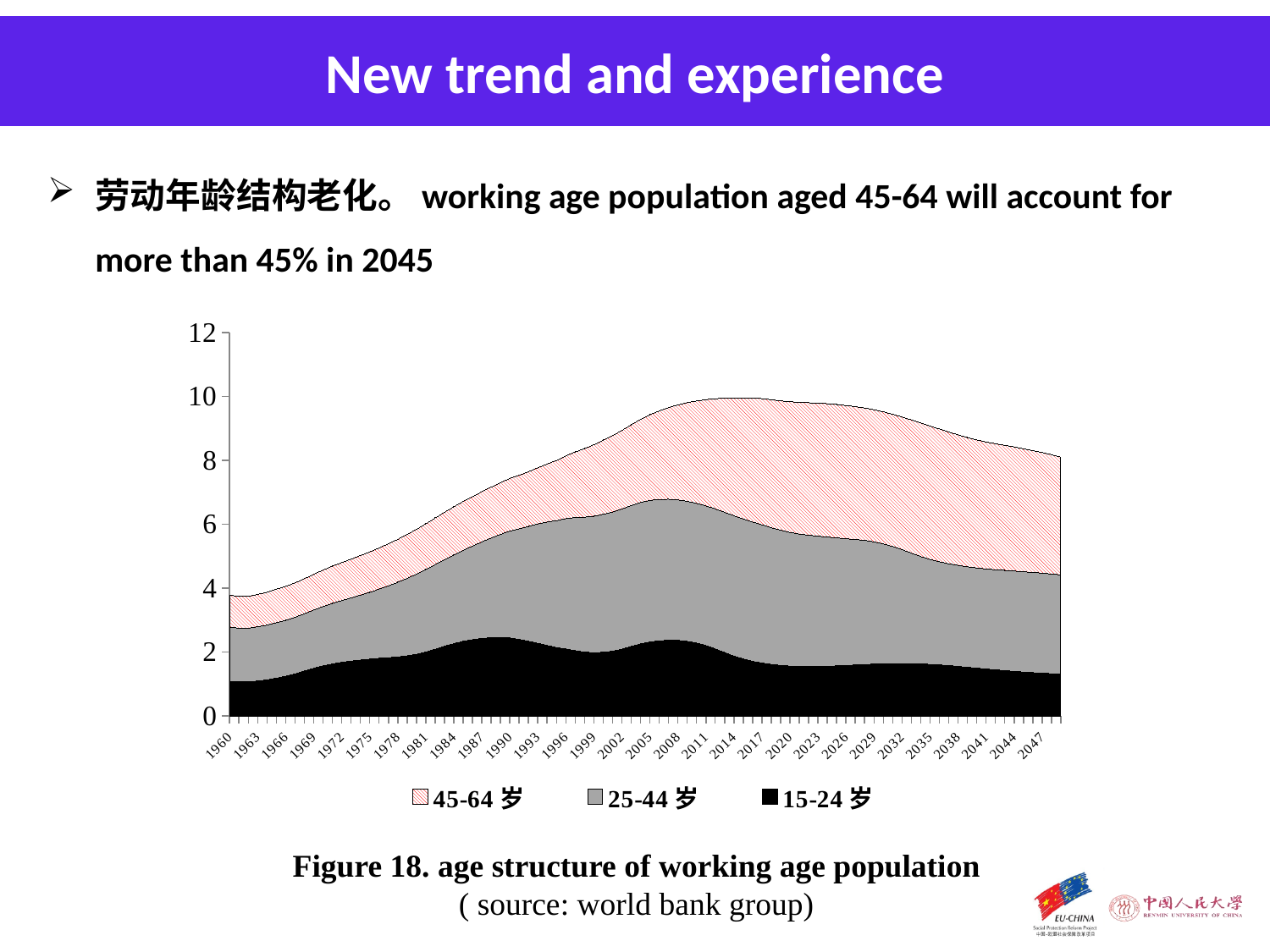
What is the highest value shown on the y axis? 12 How many series does the legend list? 3 Which series is shown in black at the bottom of the stack? 15-24 岁 Does the total working age population rise or fall between 2020 and 2047? fall Is the value for the 15-24 岁 series in 1987 greater or less than 2? greater What is the figure caption below the chart? Figure 18. age structure of working age population Is the total stacked value in 2014 greater or less than 8? greater Is the total stacked value in 2047 greater or less than the total in 2014? less What kind of chart is shown on the slide? Stacked area chart Is the value for the 15-24 岁 series in 2047 greater or less than 2? less Does the total working age population rise or fall between 1960 and 2011? rise